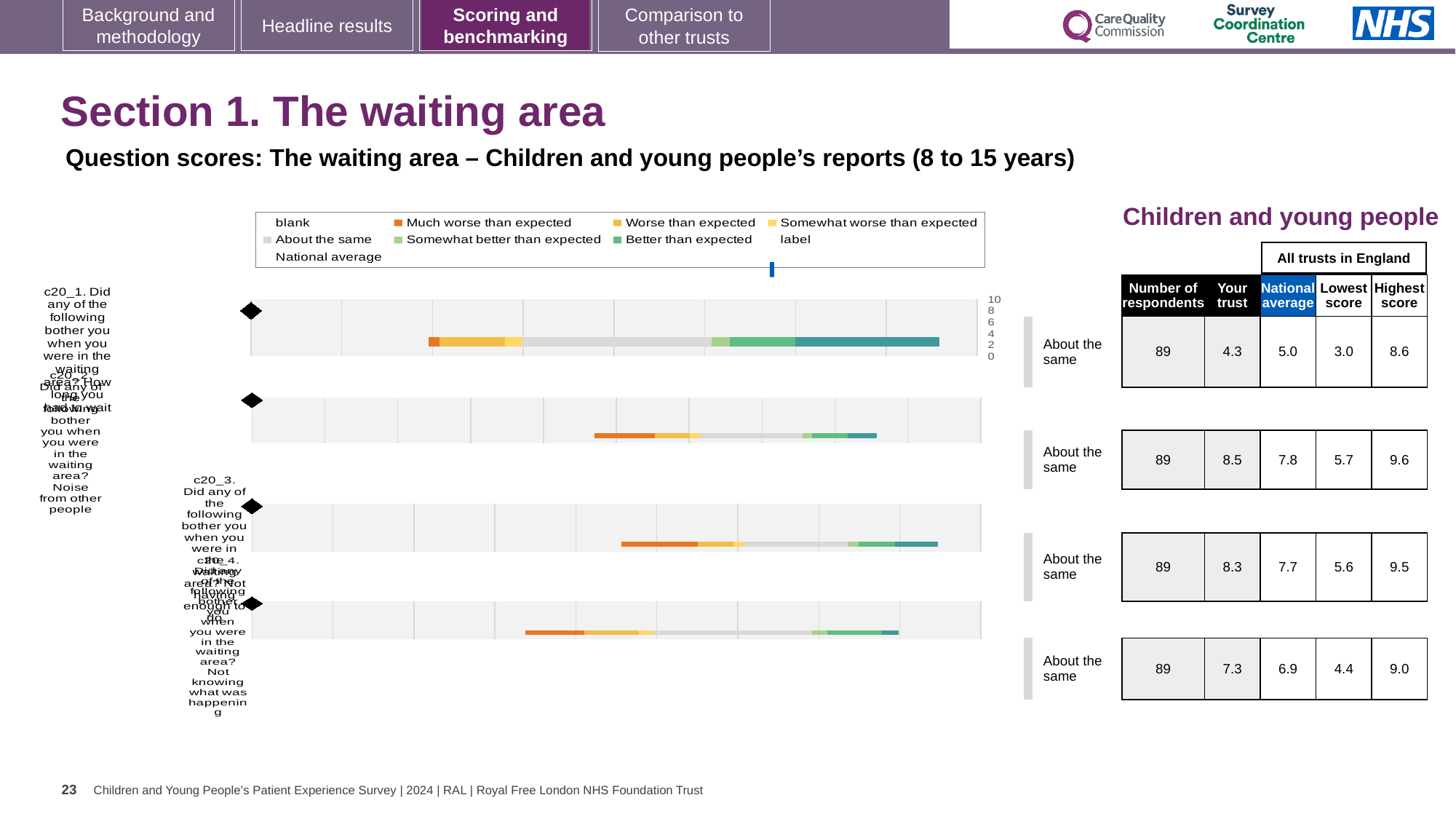
What kind of chart is shown on the slide? bar chart In the table next to the chart, what is the national average for the second question row? 7.8 In the table next to the chart, what is the 'Your trust' score for the first (top) question row? 4.3 In the table next to the chart, what is the highest score for the fourth (bottom) question row? 9.0 In the table, is the 'Your trust' score for the second row larger or smaller than its national average? larger What is the highest value shown on the chart's axis? 10 How many horizontal bars are plotted in the chart? 4 Which colour does the legend use for 'Much worse than expected'? orange In the table, which question row has the highest 'Your trust' score? the second row In the table next to the chart, how many respondents are listed for each question? 89 In the table, which question row has the lowest 'Your trust' score? the first (top) row In the table, what is the difference between the 'Your trust' score and the national average for the third question row? 0.6